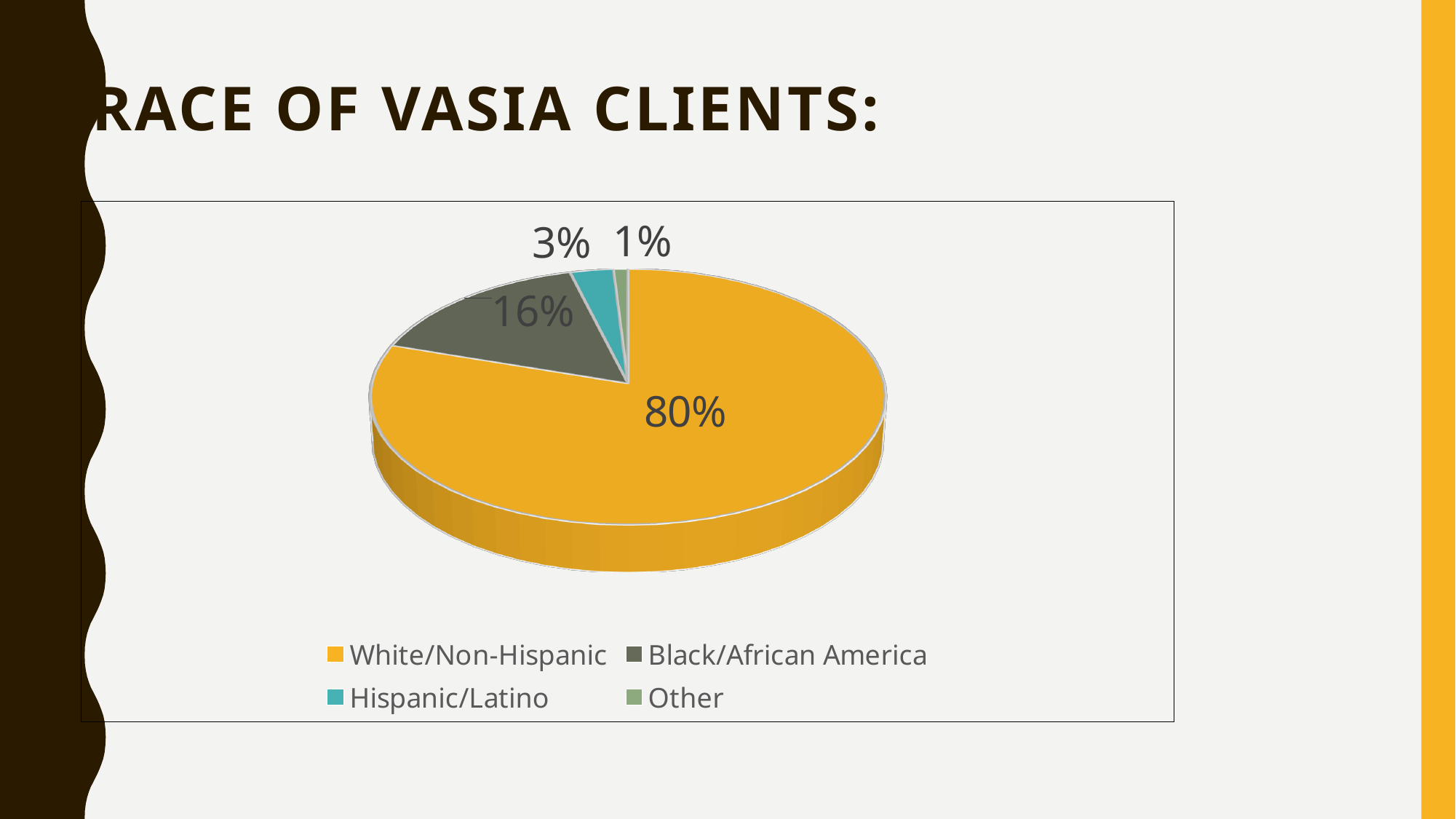
What colour is the White/Non-Hispanic slice in the pie chart? Yellow/orange What share of VASIA clients are White/Non-Hispanic? 80% What share of VASIA clients are Black/African America? 16% What is the difference in percentage points between the Hispanic/Latino and Other shares? 2 What kind of chart is shown on the slide? Pie chart Which race category has the largest share of VASIA clients? White/Non-Hispanic What share of VASIA clients are Hispanic/Latino? 3% How many race categories are shown in the pie chart? 4 What is the difference in percentage points between the White/Non-Hispanic and Black/African America shares? 64 Which race category has the smallest share of VASIA clients? Other Which is larger, the Black/African America share or the Hispanic/Latino share? Black/African America